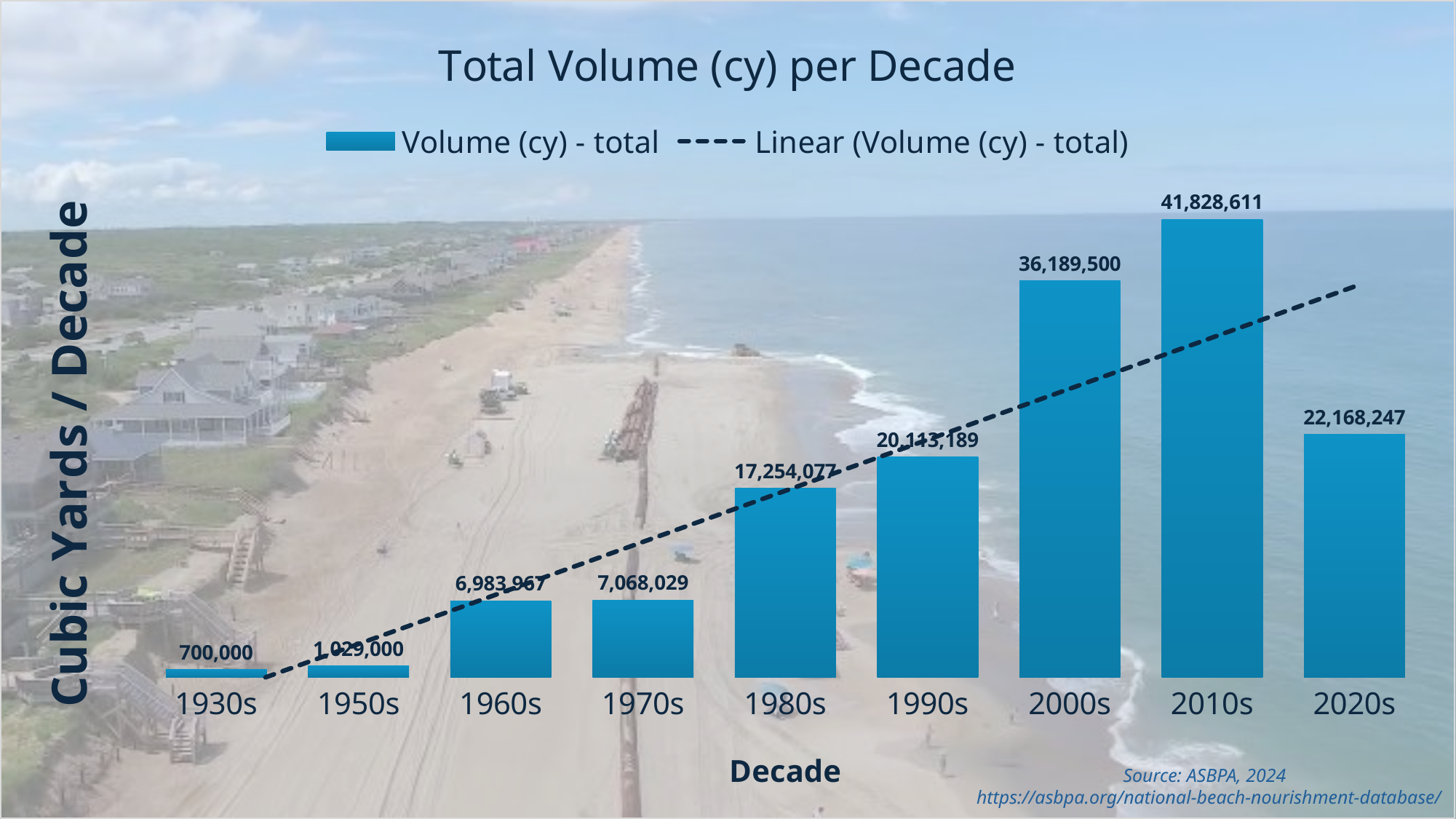
What is the difference in total volume between the 2010s and the 2000s? 5,639,111 What is the total volume (cy) for the 1980s? 17,254,077 Which decade has the highest total volume? 2010s What is the total volume (cy) for the 2010s? 41,828,611 How many decades are shown on the x axis? 9 What is the total volume (cy) for the 2000s? 36,189,500 How many entries does the legend list? 2 What is the total volume (cy) for the 1930s? 700,000 Which decade has the lowest total volume? 1930s What type of chart is shown on the slide? Bar chart Which decade has a larger total volume, the 1980s or the 2020s? 2020s What is the total volume (cy) for the 2020s? 22,168,247